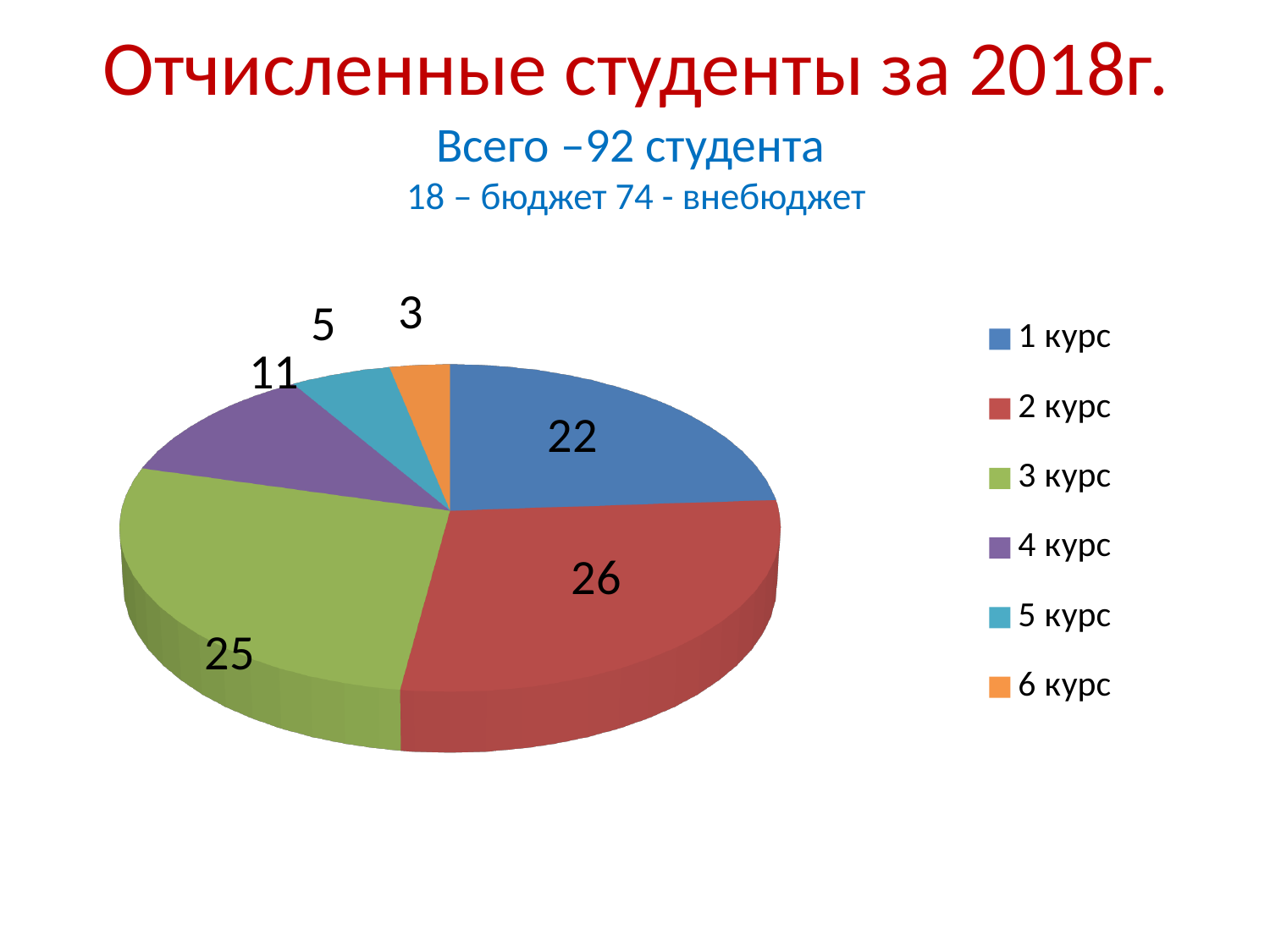
What kind of chart is shown on the slide? pie chart How many students were expelled from 2 курс according to the chart? 26 What colour is the slice for 3 курс? green What is the value shown for 6 курс? 3 Which course has the smallest slice of the pie? 6 курс What is the value shown for 1 курс? 22 What is the value shown for 4 курс? 11 How many categories (courses) does the pie chart show? 6 Which is larger, the value for 4 курс or the value for 5 курс? 4 курс What is the difference between the values for 2 курс and 3 курс? 1 What is the difference between the values for 1 курс and 5 курс? 17 Which course has the largest slice of the pie? 2 курс